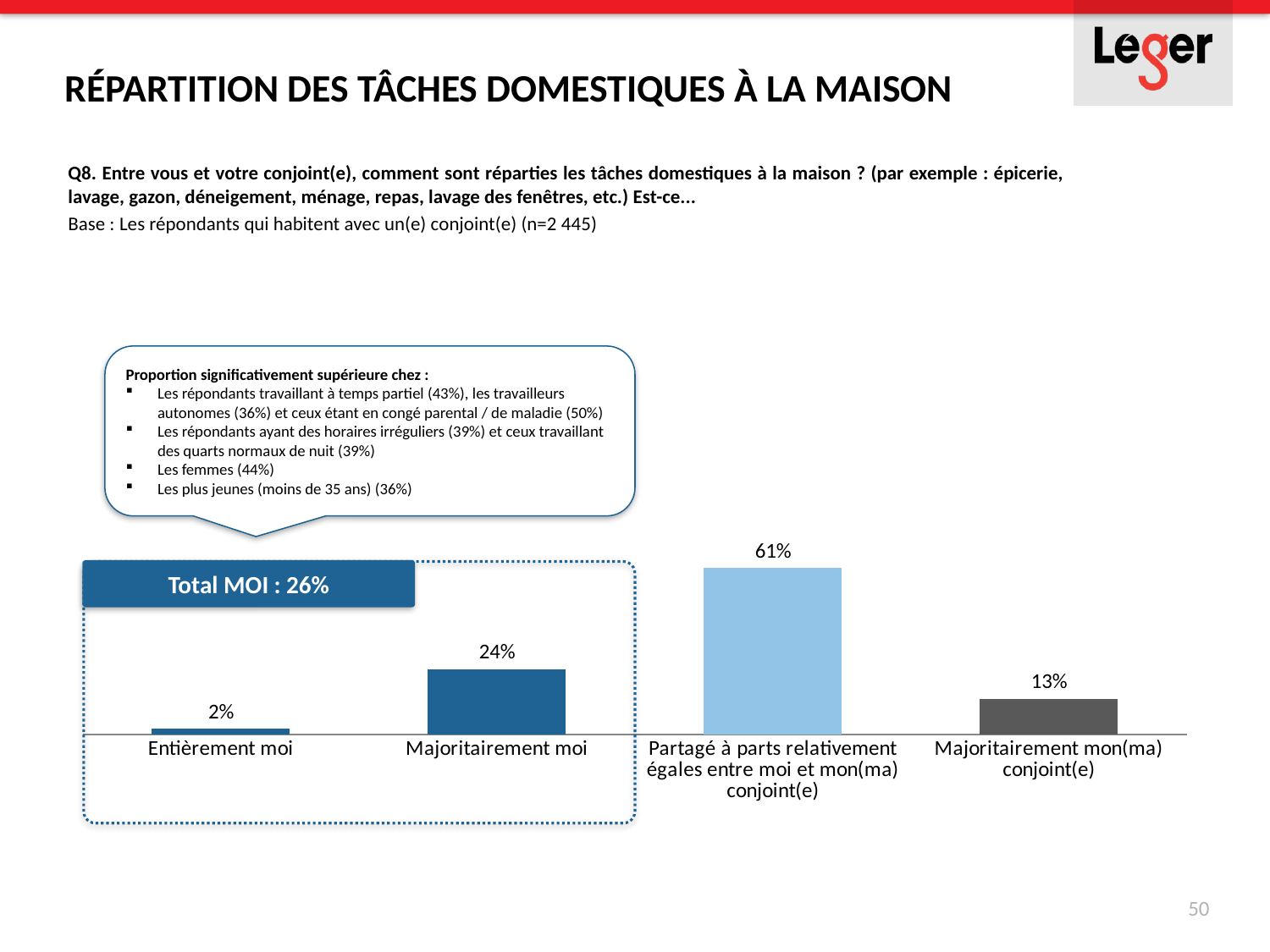
What is the sum of the values for "Entièrement moi" and "Majoritairement moi"? 26% What is the value for "Entièrement moi"? 2% Which is larger: the value for "Majoritairement moi" or the value for "Majoritairement mon(ma) conjoint(e)"? Majoritairement moi What is the value for "Majoritairement moi"? 24% Which category has the lowest value? Entièrement moi What is the value for "Partagé à parts relativement égales entre moi et mon(ma) conjoint(e)"? 61% What is the value for "Majoritairement mon(ma) conjoint(e)"? 13% What is the difference between the values for "Majoritairement moi" and "Majoritairement mon(ma) conjoint(e)"? 11% Which category has the highest value? Partagé à parts relativement égales entre moi et mon(ma) conjoint(e) How many categories are shown in the chart? 4 What is the "Total MOI" value shown in the box above the first two bars? 26% What kind of chart is shown on the slide? Bar chart